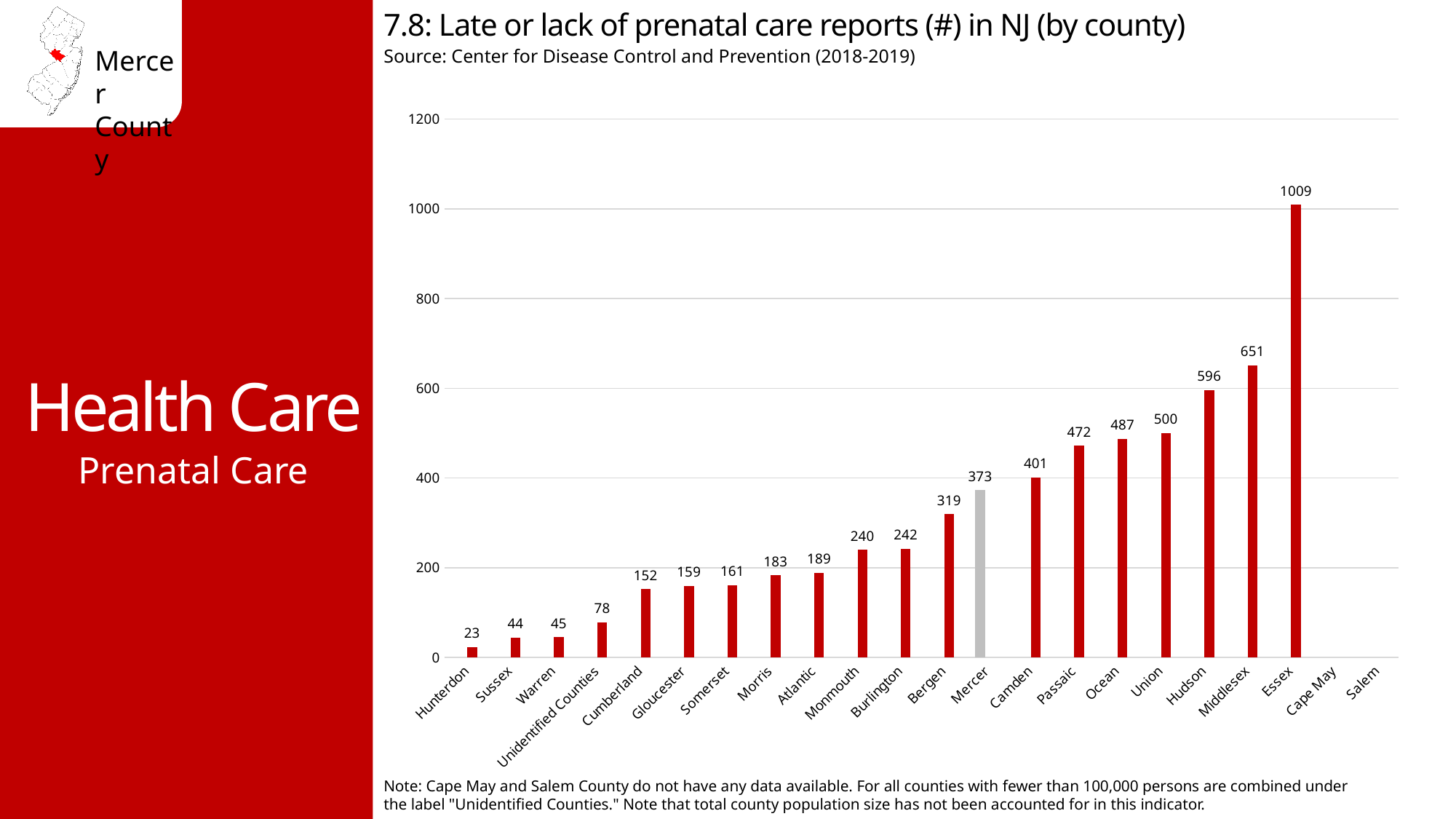
Among the counties with a plotted bar, which has the lowest value? Hunterdon Which bar is coloured grey instead of red? Mercer What is the value for Unidentified Counties? 78 Which county has the highest number of late or lack of prenatal care reports? Essex Which is larger, the value for Camden or the value for Bergen? Camden What kind of chart is shown on the slide? bar chart What is the difference between the values for Essex and Middlesex? 358 How many category labels are shown on the x axis? 22 Is the value for Hudson greater or less than 400? greater What is the value for Mercer? 373 What is the value for Essex? 1009 What is the value for Hunterdon? 23